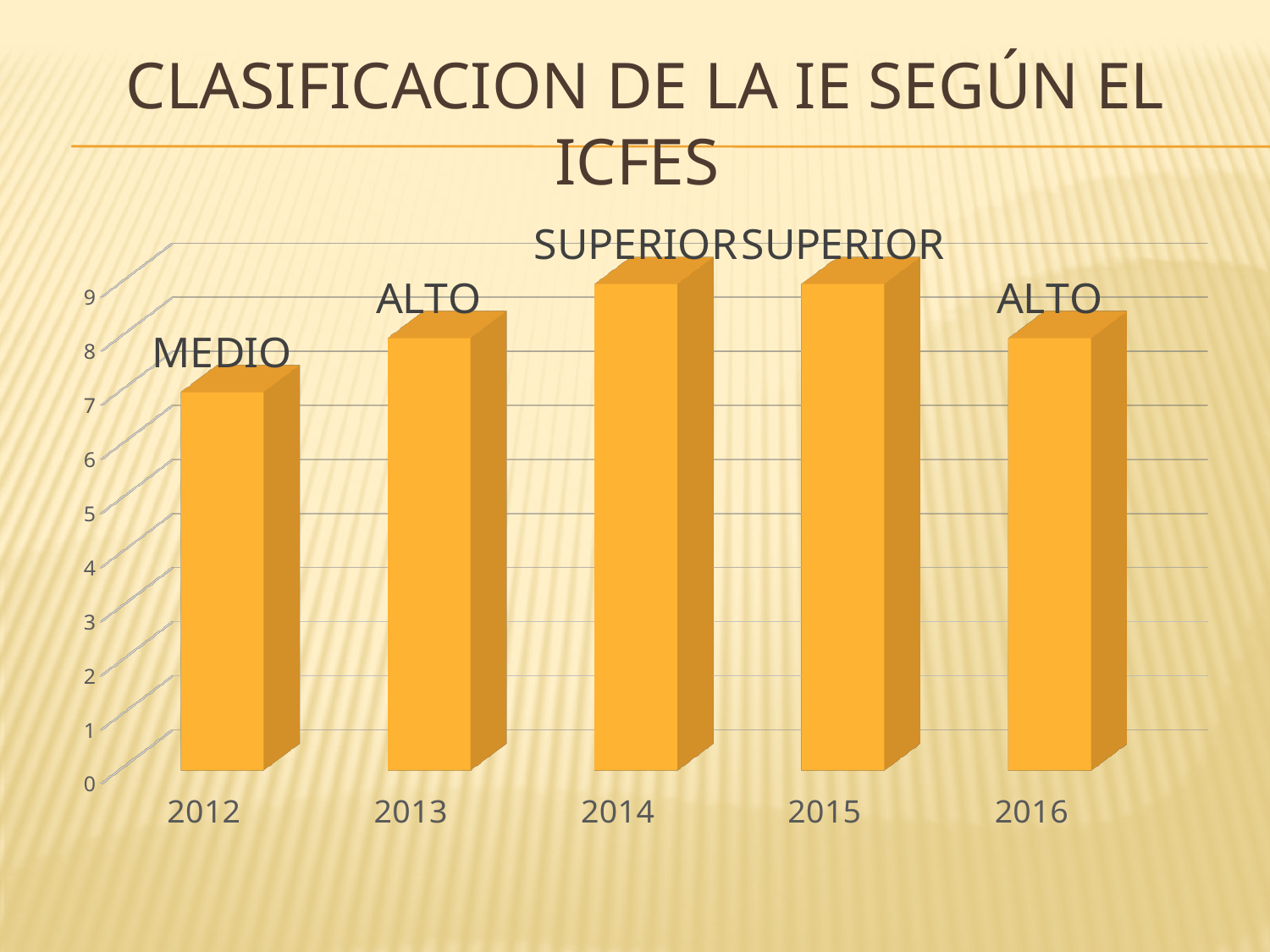
What kind of chart is shown on the slide? bar chart What label is shown above the bar for 2016? ALTO Which bar is taller, 2013 or 2014? 2014 What label is shown above the bar for 2014? SUPERIOR Is the bar for 2016 greater or less than 9? less Which year has the lowest bar in the chart? 2012 How many years are shown on the x axis of the chart? 5 What is the title of the slide containing the chart? CLASIFICACION DE LA IE SEGÚN EL ICFES Which bar is taller, 2012 or 2016? 2016 Is the bar for 2014 greater or less than 8? greater What label is shown above the bar for 2012? MEDIO Is the bar for 2012 greater or less than 8? less